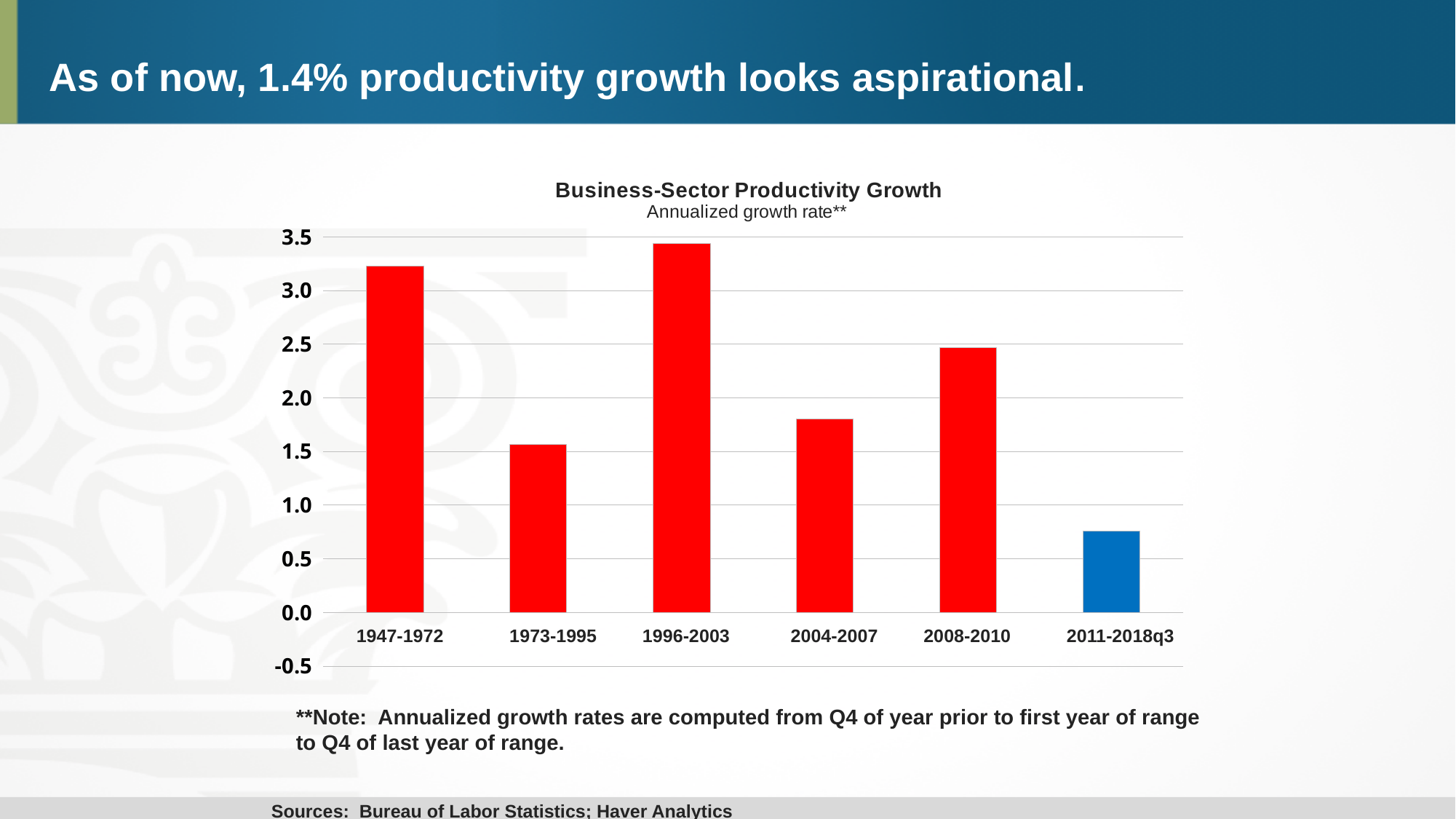
Which period has the larger growth rate, 2008-2010 or 2004-2007? 2008-2010 Is the value for 1947-1972 greater or less than 3.0? greater Is the value for 2004-2007 greater or less than 2.0? less How many time periods are plotted in the Business-Sector Productivity Growth chart? 6 Is the value for 2008-2010 greater or less than 2.0? greater What kind of chart is shown on the slide? bar chart Which period has the larger growth rate, 1947-1972 or 1973-1995? 1947-1972 What colour is the bar for 2011-2018q3? blue Which period has the highest annualized productivity growth rate? 1996-2003 Which period has the lowest annualized productivity growth rate? 2011-2018q3